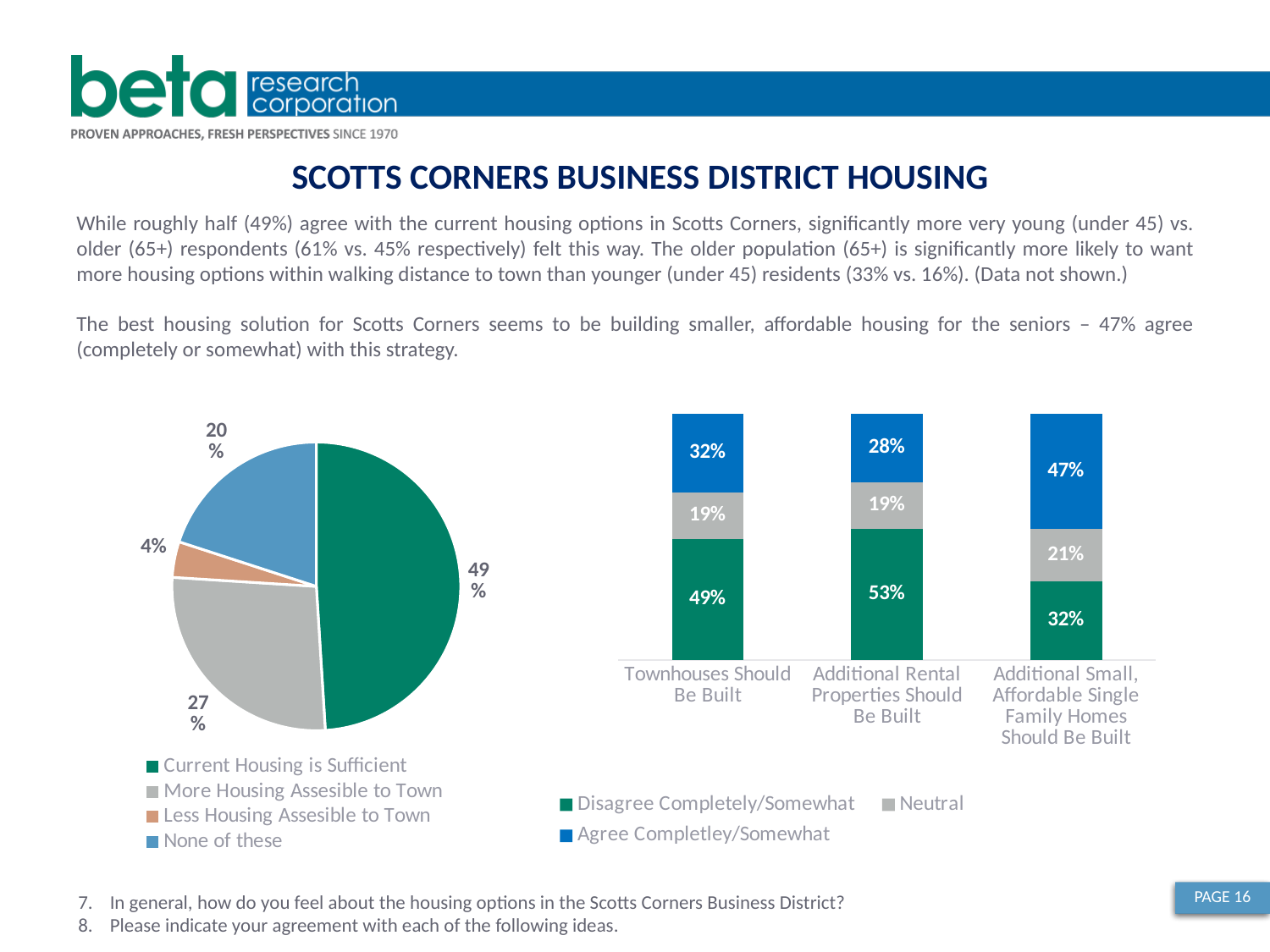
In the stacked bar chart on the right, is the Agree Completley/Somewhat value larger for Townhouses Should Be Built or for Additional Rental Properties Should Be Built? Townhouses Should Be Built In the stacked bar chart on the right, what is the Neutral value for Additional Rental Properties Should Be Built? 19% In the stacked bar chart on the right, what percentage Agree Completley/Somewhat that Additional Small, Affordable Single Family Homes Should Be Built? 47% In the pie chart on the left, what share of respondents said Current Housing is Sufficient? 49% What kind of chart is the chart on the left of the slide? Pie chart In the pie chart on the left, which category has the smallest slice? Less Housing Assesible to Town In the pie chart on the left, what is the difference between More Housing Assesible to Town and None of these? 7% What kind of chart is the chart on the right of the slide? Stacked bar chart How many series does the legend of the stacked bar chart on the right list? 3 In the stacked bar chart on the right, which idea has the highest Disagree Completely/Somewhat value? Additional Rental Properties Should Be Built In the stacked bar chart on the right, what is the difference between the Disagree Completely/Somewhat values for Additional Rental Properties Should Be Built and Additional Small, Affordable Single Family Homes Should Be Built? 21% How many slices does the pie chart on the left have? 4